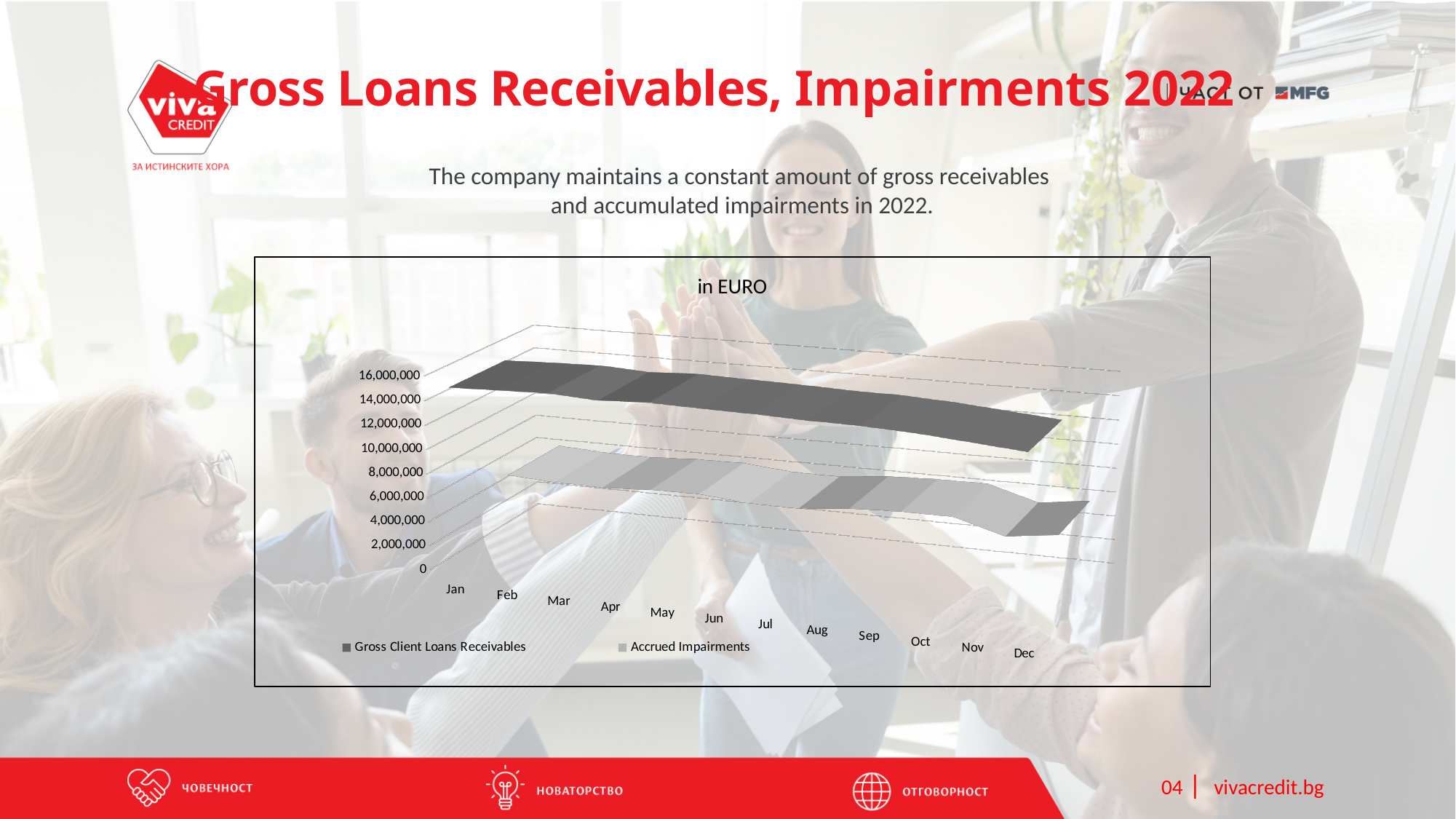
How many series does the chart legend list? 2 What are the two series named in the chart legend? Gross Client Loans Receivables and Accrued Impairments How many months are plotted along the x axis of the chart? 12 What kind of chart is shown on the slide? 3D line chart What is the highest value labelled on the vertical axis of the chart? 16,000,000 What is the title shown above the chart? in EURO What is the first month shown on the x axis of the chart? Jan Is the value for Accrued Impairments in Jan greater or less than 2,000,000? greater Which series has the larger values throughout the year, Gross Client Loans Receivables or Accrued Impairments? Gross Client Loans Receivables Is the value for Gross Client Loans Receivables in Jan greater or less than 10,000,000? greater Is the value for Accrued Impairments in Dec greater or less than 14,000,000? less